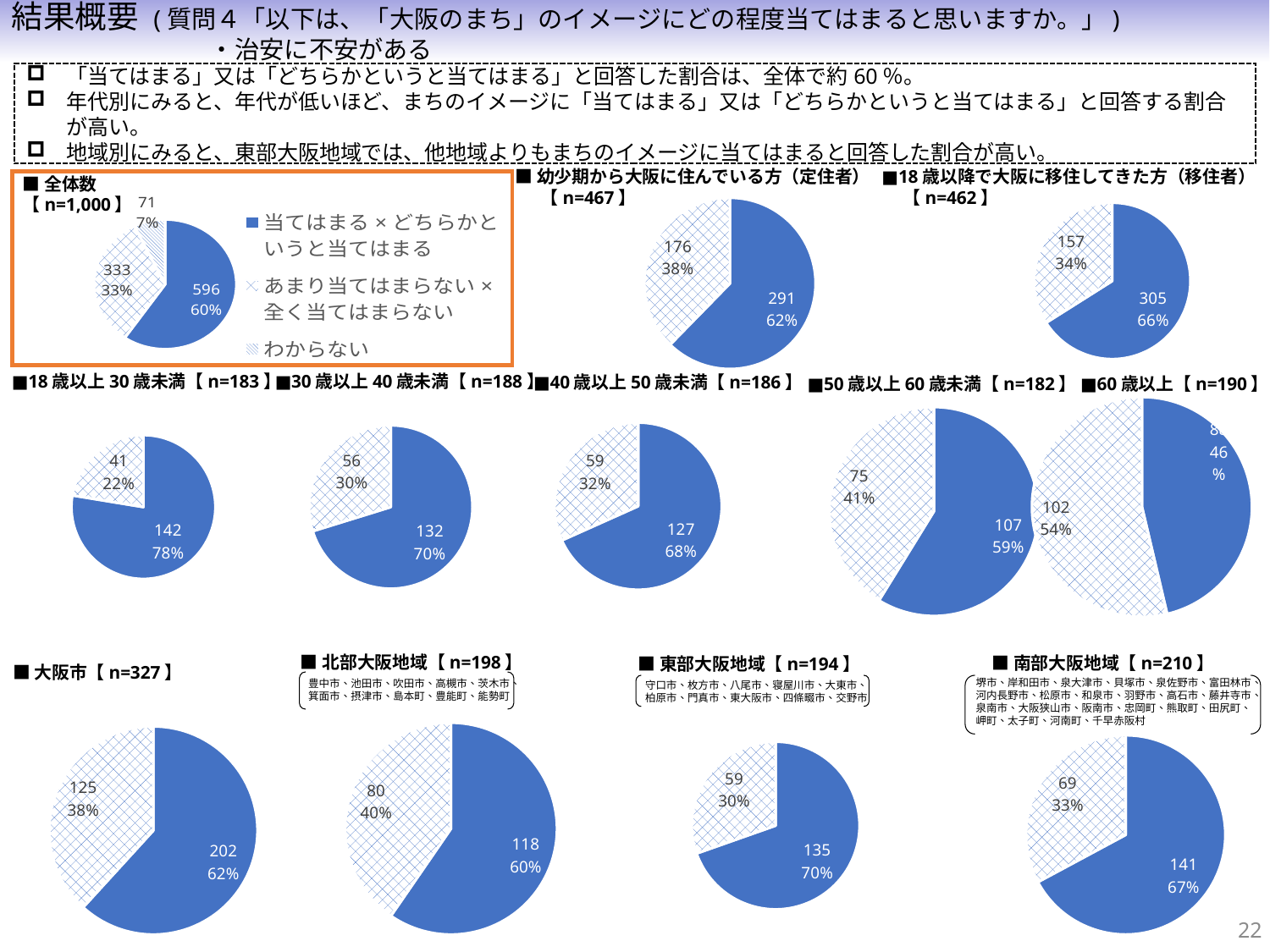
Which is larger in the 東部大阪地域 pie chart: the 当てはまる × どちらかというと当てはまる slice or the あまり当てはまらない × 全く当てはまらない slice? 当てはまる × どちらかというと当てはまる In the 50歳以上60歳未満 pie chart, what is the difference between the counts of the two slices (107 and 75)? 32 In the 大阪市 pie chart, what is the count for the あまり当てはまらない × 全く当てはまらない slice? 125 Among the four regional pie charts (大阪市, 北部大阪地域, 東部大阪地域, 南部大阪地域), which shows the highest percentage for 当てはまる × どちらかというと当てはまる? 東部大阪地域 In the 18歳以上30歳未満 pie chart, what percentage is shown for the 当てはまる × どちらかというと当てはまる slice? 78% How many entries does the legend of the 全体数 chart list? 3 In the 全体数 pie chart, what percentage share is shown for わからない? 7% In the 18歳以降で大阪に移住してきた方（移住者） pie chart, what percentage is shown for the あまり当てはまらない × 全く当てはまらない slice? 34% Which age-group pie chart shows the highest percentage for 当てはまる × どちらかというと当てはまる? 18歳以上30歳未満 In the 幼少期から大阪に住んでいる方（定住者） pie chart, what is the count for the 当てはまる × どちらかというと当てはまる slice? 291 In the 全体数 pie chart, what is the count for 当てはまる × どちらかというと当てはまる? 596 What kind of chart is used for the 全体数 data? pie chart